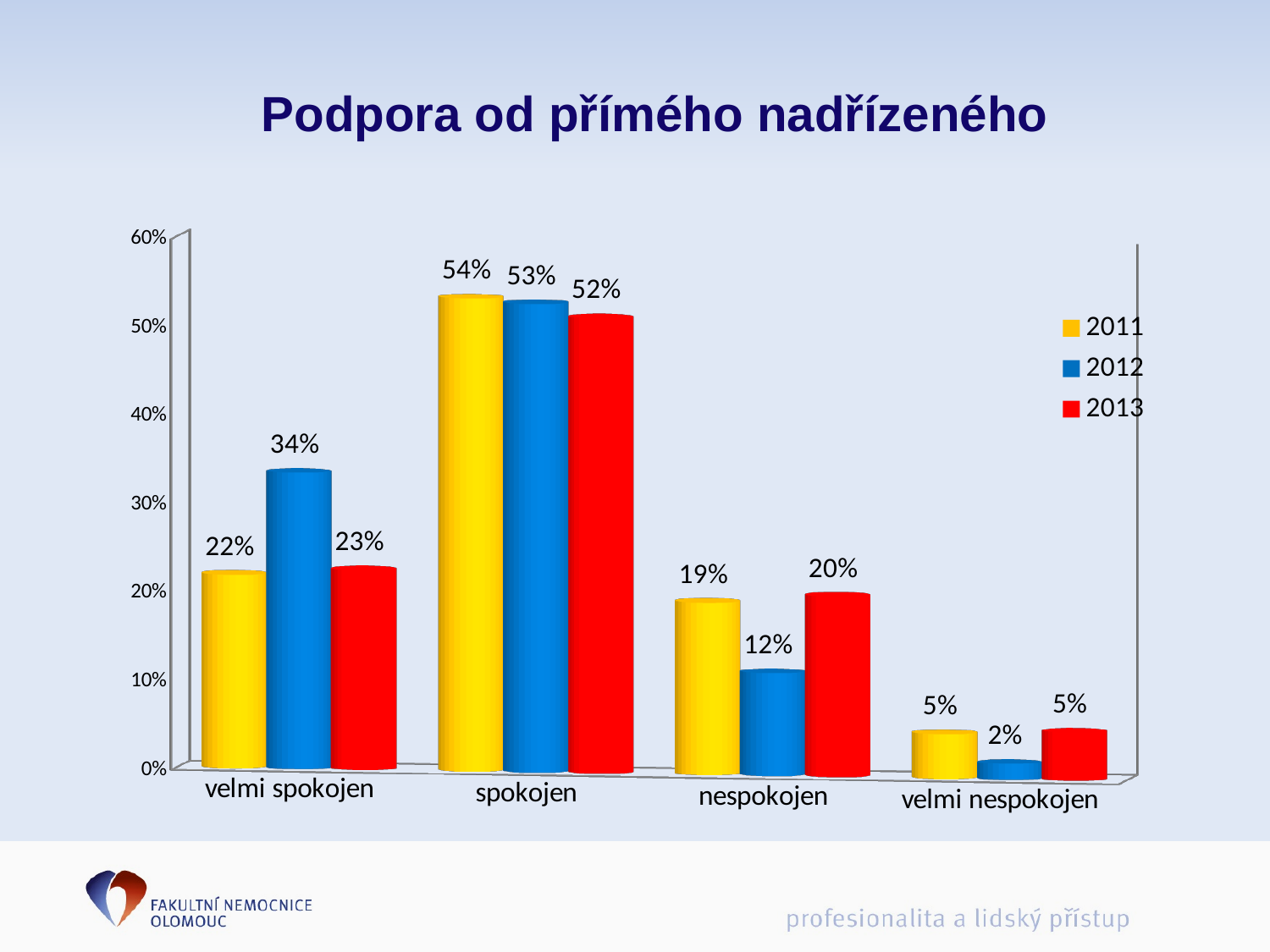
How many categories are shown on the x axis? 4 What is the value for 'spokojen' in 2013? 52% What is the difference between the 2012 and 2011 values for 'velmi spokojen'? 12% What is the value for 'nespokojen' in 2012? 12% Which is larger for 'nespokojen': the 2011 value or the 2013 value? 2013 What is the value for 'velmi spokojen' in 2012? 34% Which category has the lowest value in 2012? velmi nespokojen What kind of chart is shown on the slide? bar chart What is the title of the chart? Podpora od přímého nadřízeného What is the value for 'velmi nespokojen' in 2011? 5% Which category has the highest value in 2011? spokojen How many series does the legend list? 3